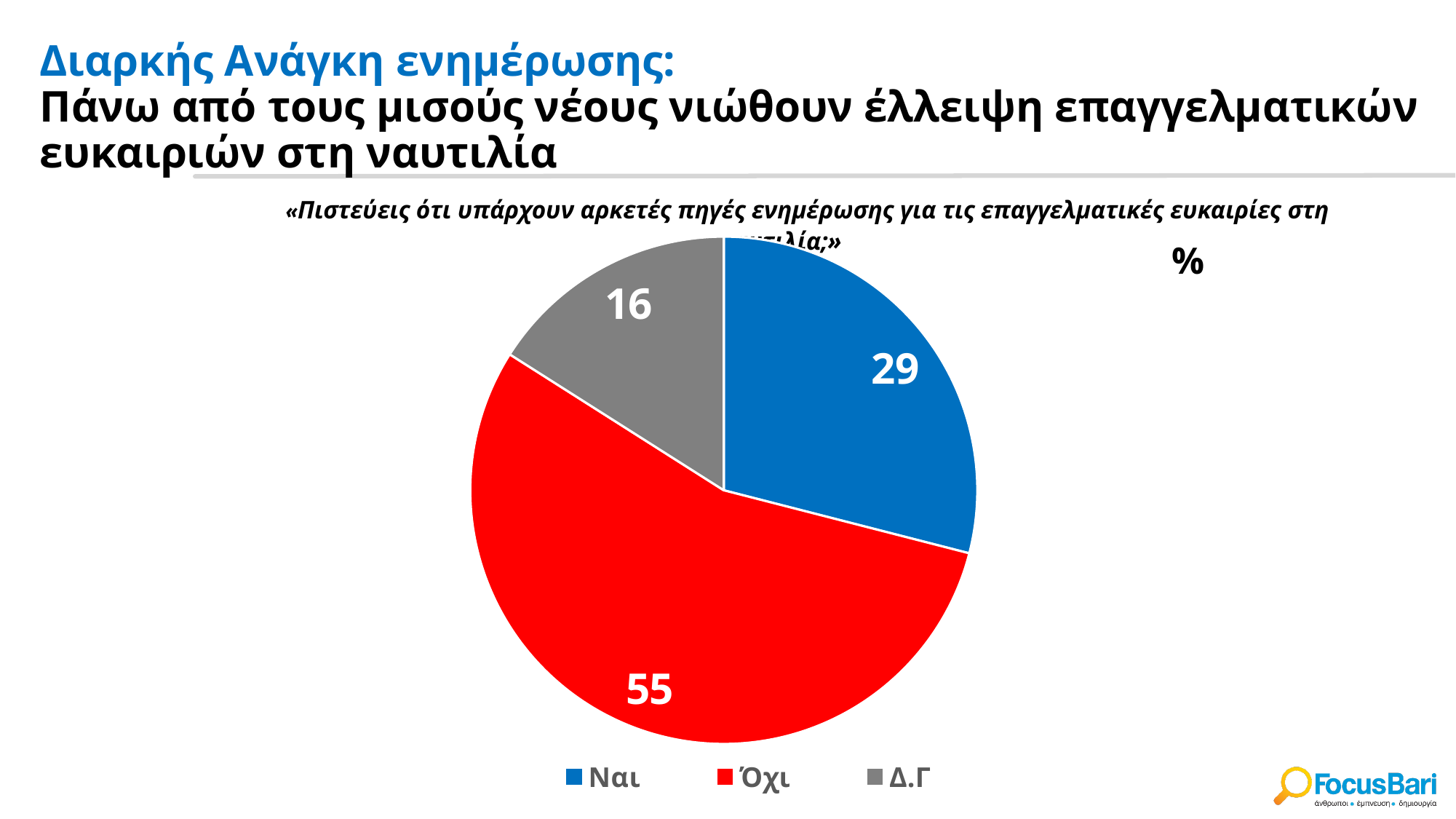
Which category has the largest slice? Όχι What colour is the slice for Όχι? red How many entries does the legend list? 3 What is the value for Όχι? 55 What type of chart is shown on the slide? pie chart What is the value for Δ.Γ? 16 Which category has the smallest slice? Δ.Γ What is the difference between the values for Ναι and Δ.Γ? 13 Which is larger, the value for Ναι or the value for Δ.Γ? Ναι How many slices does the pie chart have? 3 What is the difference between the values for Όχι and Ναι? 26 What is the value for Ναι? 29